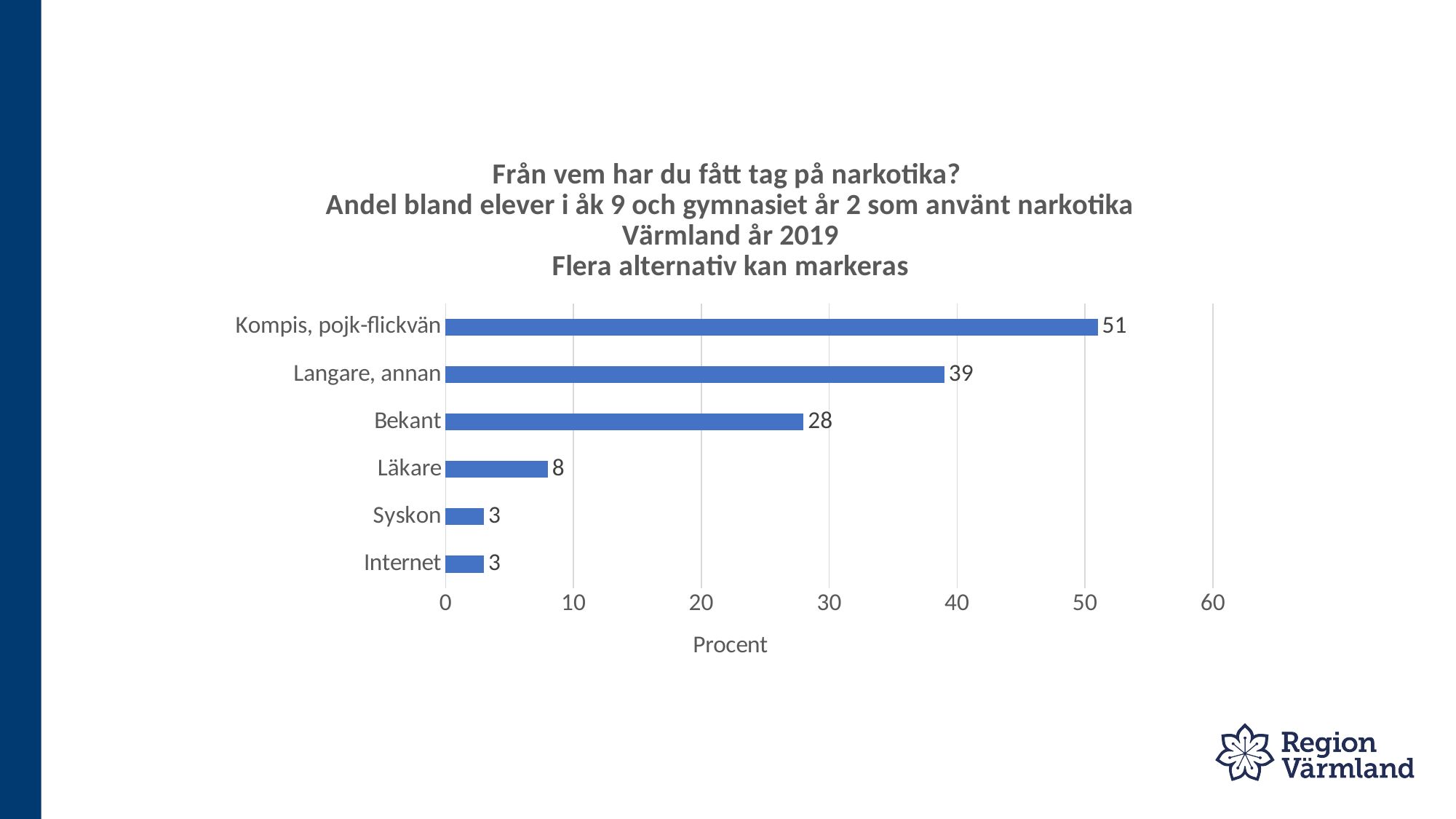
What is the value for Bekant? 28 What is the value for Kompis, pojk-flickvän? 51 Which category has the highest value? Kompis, pojk-flickvän Is the value for Langare, annan greater or less than 30? greater What is the difference between the values for Bekant and Läkare? 20 Which is larger, the value for Langare, annan or the value for Bekant? Langare, annan What is the value for Läkare? 8 What is the difference between the values for Kompis, pojk-flickvän and Langare, annan? 12 What is the value for Syskon? 3 How many categories are shown in the chart? 6 What kind of chart is shown on the slide? Bar chart What is the label of the horizontal axis? Procent